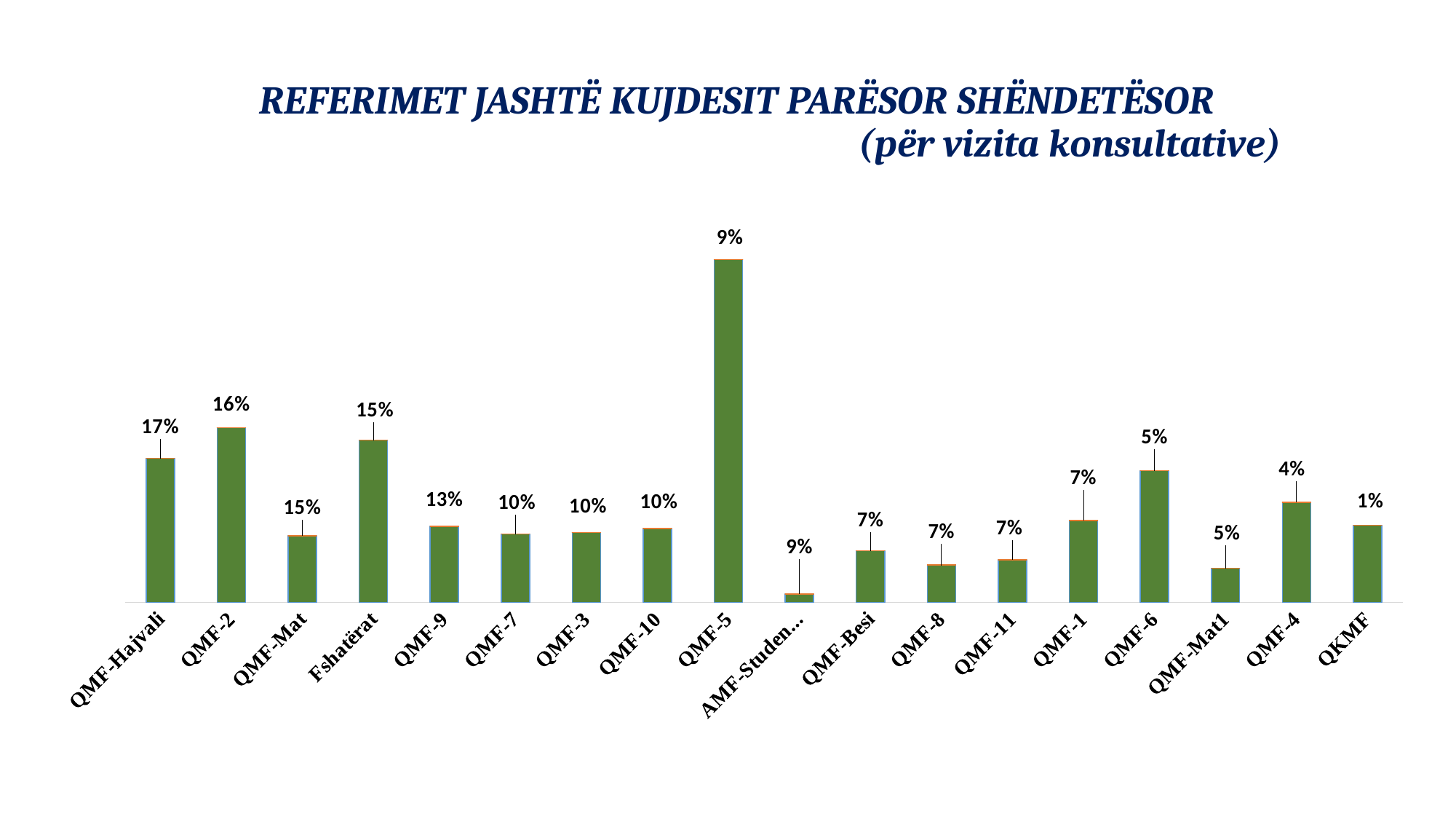
How many categories are shown on the x axis of the chart? 18 What is the difference between the values for QMF-9 and QMF-4? 9% What is the value shown for QMF-4? 4% What is the value shown for QKMF? 1% Which has a larger value, QMF-Hajvali or QMF-4? QMF-Hajvali What is the value shown for QMF-9? 13% What is the value shown for QMF-2? 16% What is the value shown for QMF-Hajvali? 17% What is the difference between the values for QMF-Hajvali and QMF-2? 1% What colour are the bars in the chart? Green What kind of chart is shown on the slide? Bar chart What is the value shown for Fshatërat? 15%